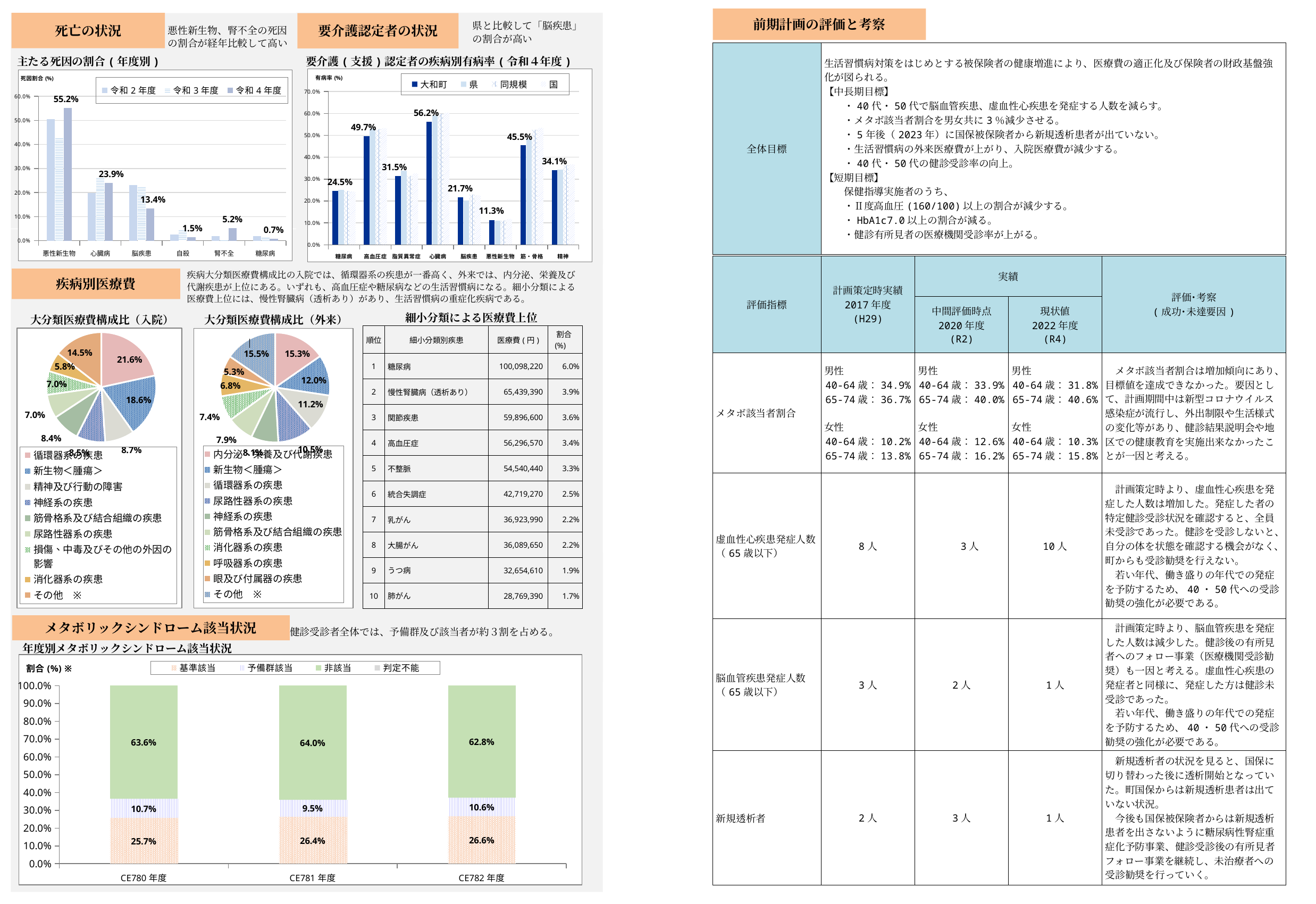
In the 大分類医療費構成比(入院) pie chart, what share does 循環器系の疾患 have? 21.6% In the 大分類医療費構成比(外来) pie chart, what share does 内分泌、栄養及び代謝疾患 have? 15.3% In the 主たる死因の割合(年度別) chart, which cause of death has the lowest 令和4年度 value? 糖尿病 What kind of chart is 年度別メタボリックシンドローム該当状況? stacked bar chart In the 主たる死因の割合(年度別) chart, how many series does the legend list? 3 In the 要介護(支援)認定者の疾病別有病率(令和4年度) chart, which disease has the highest 大和町 value? 心臓病 In the 主たる死因の割合(年度別) chart, what is the 令和4年度 value for 悪性新生物? 55.2% In the 年度別メタボリックシンドローム該当状況 chart, is the 基準該当 value for CE782年度 larger or smaller than for CE780年度? larger In the 要介護(支援)認定者の疾病別有病率(令和4年度) chart, what is the difference between the 大和町 values for 高血圧症 and 糖尿病? 25.2% In the 要介護(支援)認定者の疾病別有病率(令和4年度) chart, what is the 大和町 value for 心臓病? 56.2% In the 年度別メタボリックシンドローム該当状況 chart, what is the 非該当 value for CE781年度? 64.0% In the 要介護(支援)認定者の疾病別有病率(令和4年度) chart, how many disease categories are shown on the x axis? 8